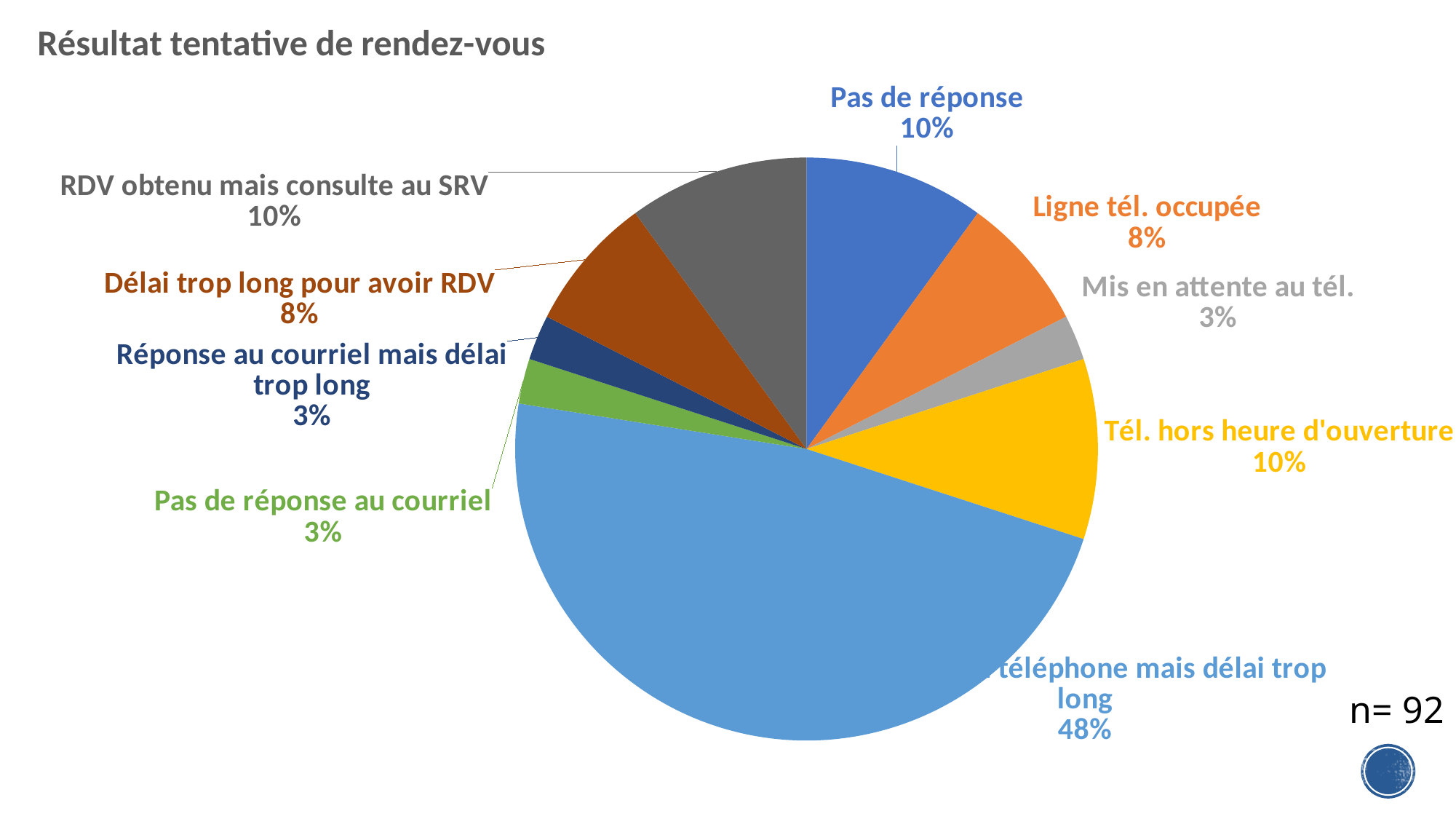
How many slices does the pie chart have? 9 What share of the pie does "Tél. hors heure d'ouverture" represent? 10% What share of the pie does "Délai trop long pour avoir RDV" represent? 8% What share of the pie does "Pas de réponse" represent? 10% What sample size (n) is indicated on the slide? n= 92 What is the title of the chart? Résultat tentative de rendez-vous What is the percentage shown for the largest slice of the pie? 48% What is the difference in percentage points between "Pas de réponse" and "Ligne tél. occupée"? 2 percentage points What share of the pie does "RDV obtenu mais consulte au SRV" represent? 10% Which is larger: "Tél. hors heure d'ouverture" or "Mis en attente au tél."? Tél. hors heure d'ouverture What kind of chart is shown on the slide? Pie chart What share of the pie does "Ligne tél. occupée" represent? 8%